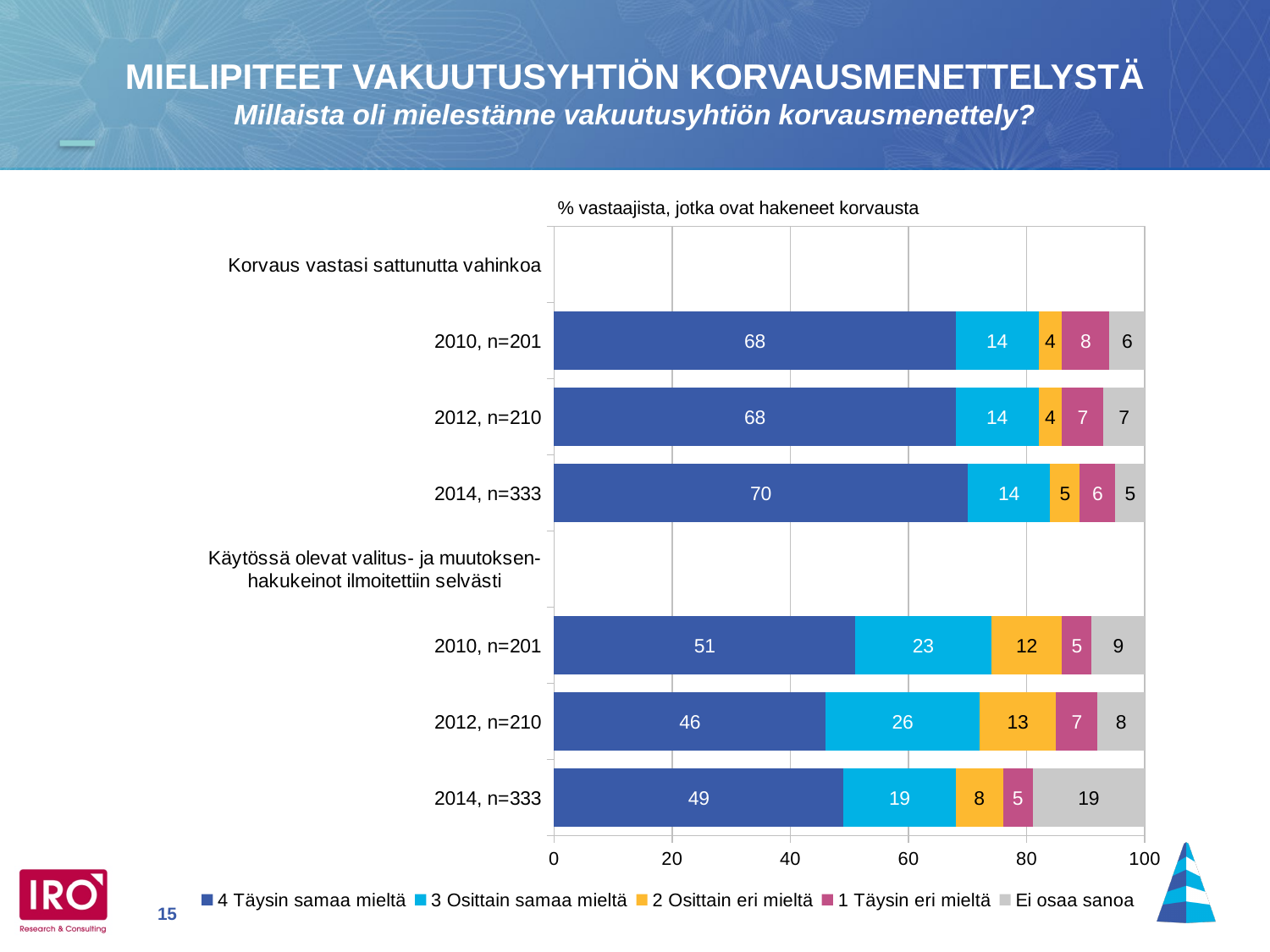
What is the total of the stacked bar for 2010, n=201 under "Käytössä olevat valitus- ja muutoksenhakukeinot ilmoitettiin selvästi"? 100 What is the value for "1 Täysin eri mieltä" in the 2010, n=201 bar under "Korvaus vastasi sattunutta vahinkoa"? 8 Under "Käytössä olevat valitus- ja muutoksenhakukeinot ilmoitettiin selvästi", which year has the larger value for "2 Osittain eri mieltä": 2012, n=210 or 2014, n=333? 2012, n=210 Under "Käytössä olevat valitus- ja muutoksenhakukeinot ilmoitettiin selvästi", which year has the lowest value for "4 Täysin samaa mieltä"? 2012, n=210 What is the value for "3 Osittain samaa mieltä" in the 2012, n=210 bar under "Käytössä olevat valitus- ja muutoksenhakukeinot ilmoitettiin selvästi"? 26 What is the value for "Ei osaa sanoa" in the 2014, n=333 bar under "Käytössä olevat valitus- ja muutoksenhakukeinot ilmoitettiin selvästi"? 19 Under "Korvaus vastasi sattunutta vahinkoa", which year has the highest value for "4 Täysin samaa mieltä"? 2014, n=333 What is the difference between the "4 Täysin samaa mieltä" value for 2010, n=201 under "Korvaus vastasi sattunutta vahinkoa" and the same value for 2010, n=201 under "Käytössä olevat valitus- ja muutoksenhakukeinot ilmoitettiin selvästi"? 17 How many stacked bars are plotted in the chart? 6 How many series does the legend list? 5 What is the value for "4 Täysin samaa mieltä" in the 2014, n=333 bar under "Korvaus vastasi sattunutta vahinkoa"? 70 What kind of chart is shown on the slide? Stacked bar chart